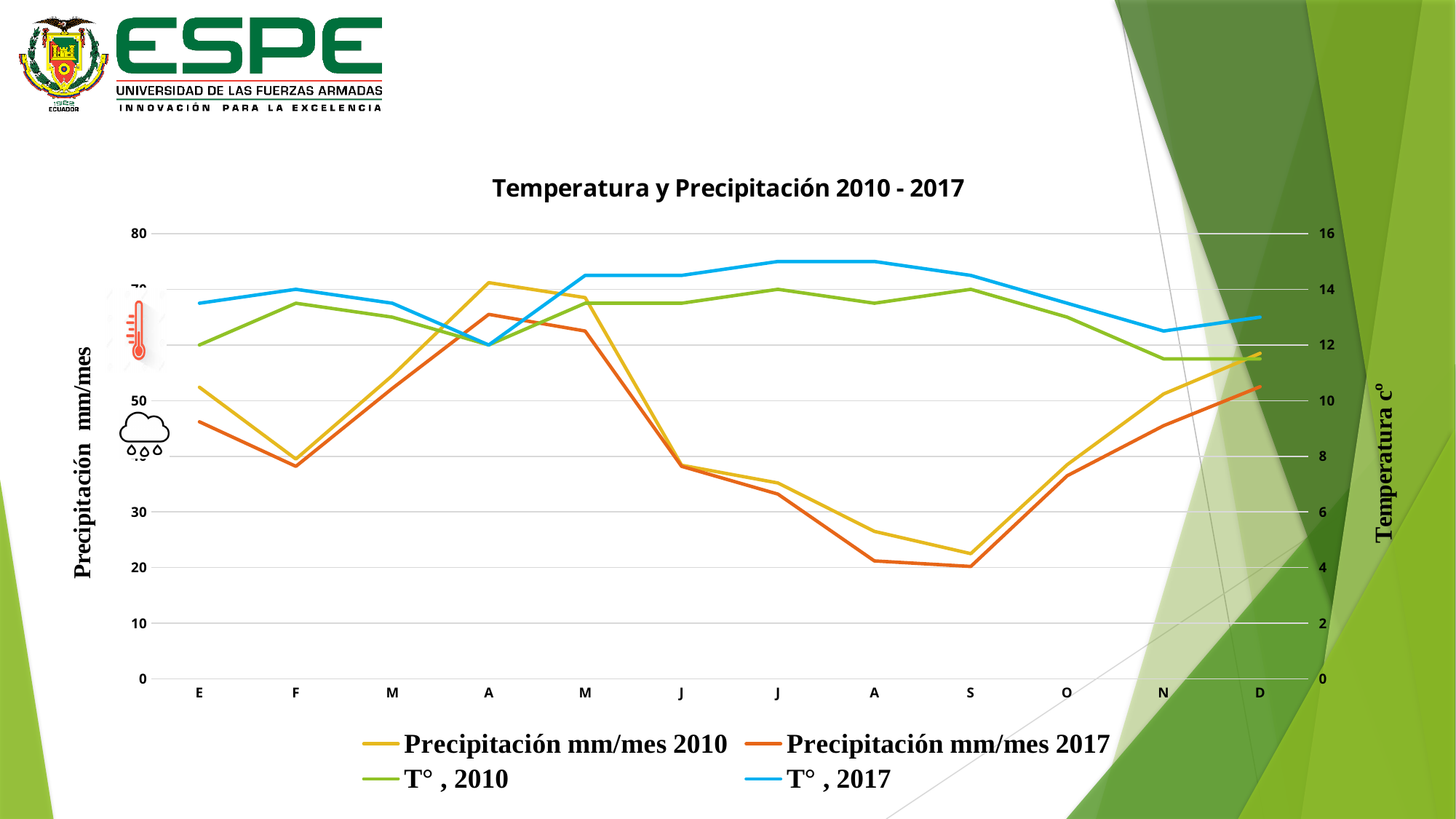
Is the Precipitación mm/mes 2017 value in S greater or less than 30? less Does the Precipitación mm/mes 2017 series rise or fall from M (May) to S? fall What is the title of the chart? Temperatura y Precipitación 2010 - 2017 Is the T° , 2017 value in J (July) greater or less than 14? greater What colour is the T° , 2017 line? blue In which month does the Precipitación mm/mes 2010 series reach its highest value? A (April) How many months are plotted along the x axis? 12 In E, which series is higher: Precipitación mm/mes 2010 or Precipitación mm/mes 2017? Precipitación mm/mes 2010 What kind of chart is shown on the slide? line chart In which month is the T° , 2017 series at its lowest? A (April) In which month does the Precipitación mm/mes 2017 series reach its lowest value? S How many series does the legend list? 4